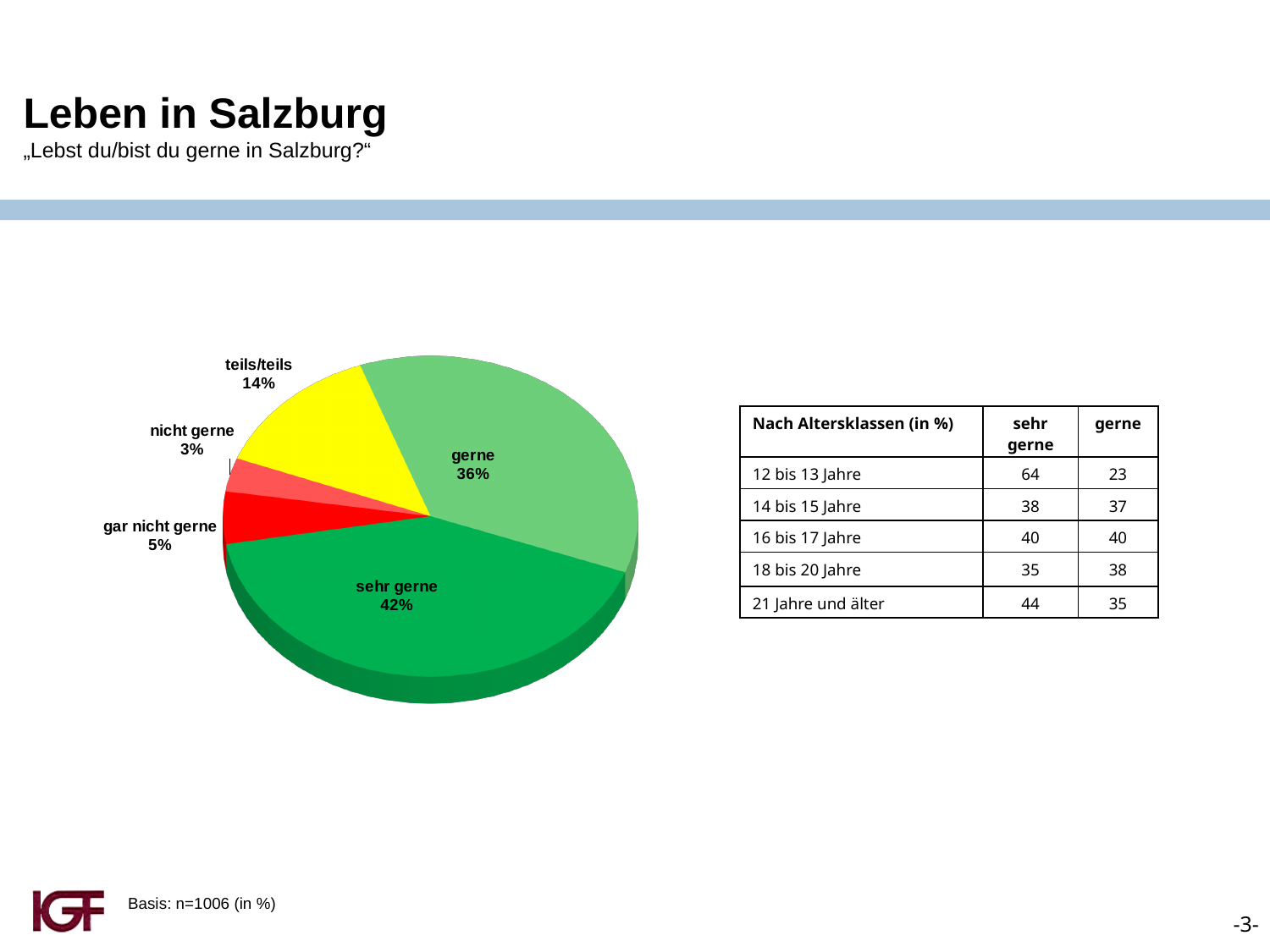
What share of the pie is labelled "teils/teils"? 14% What is the combined share of "sehr gerne" and "gerne"? 78% What percentage of respondents answered "gerne"? 36% Which response category has the smallest slice of the pie? nicht gerne Which response category has the largest slice of the pie? sehr gerne What type of chart is shown on the slide? pie chart How many response categories are shown in the pie chart? 5 What is the difference in percentage points between "sehr gerne" and "gerne"? 6 What percentage of respondents answered "sehr gerne"? 42% Which is larger: the share for "gar nicht gerne" or the share for "nicht gerne"? gar nicht gerne What colour is the "teils/teils" slice of the pie? yellow What percentage of respondents answered "nicht gerne"? 3%